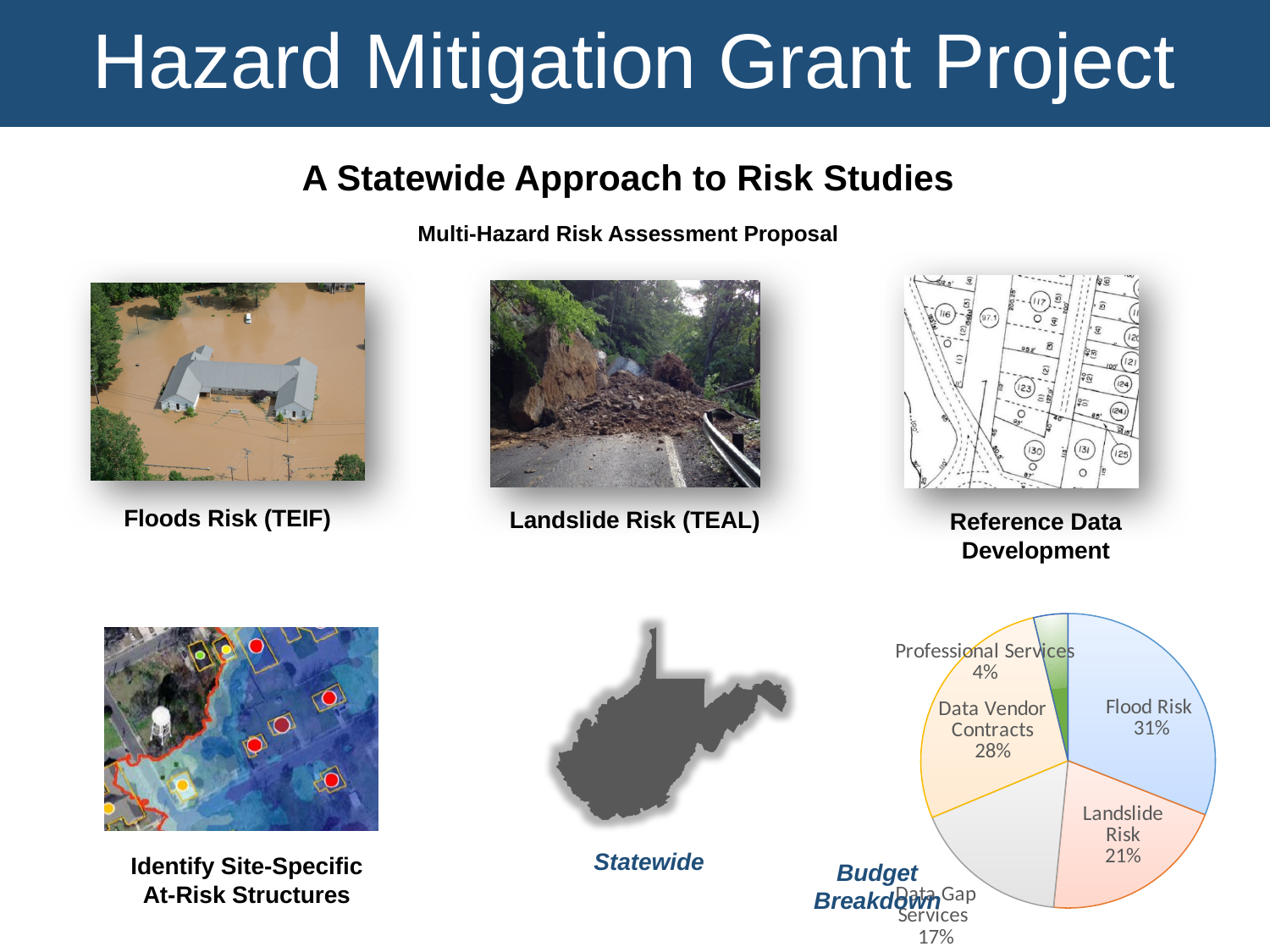
What kind of chart is the Budget Breakdown chart? pie chart In the Budget Breakdown pie chart, which is larger: Data Vendor Contracts or Data Gap Services? Data Vendor Contracts In the Budget Breakdown pie chart, what share is Flood Risk? 31% In the Budget Breakdown pie chart, what share is Professional Services? 4% In the Budget Breakdown pie chart, what share is Data Vendor Contracts? 28% In the Budget Breakdown pie chart, what share is Landslide Risk? 21% In the Budget Breakdown pie chart, what is the difference between the Flood Risk and Landslide Risk shares? 10% What is the title of the pie chart on the slide? Budget Breakdown In the Budget Breakdown pie chart, how many slices are there? 5 In the Budget Breakdown pie chart, what share is Data Gap Services? 17% In the Budget Breakdown pie chart, which slice is the largest? Flood Risk In the Budget Breakdown pie chart, which slice is the smallest? Professional Services